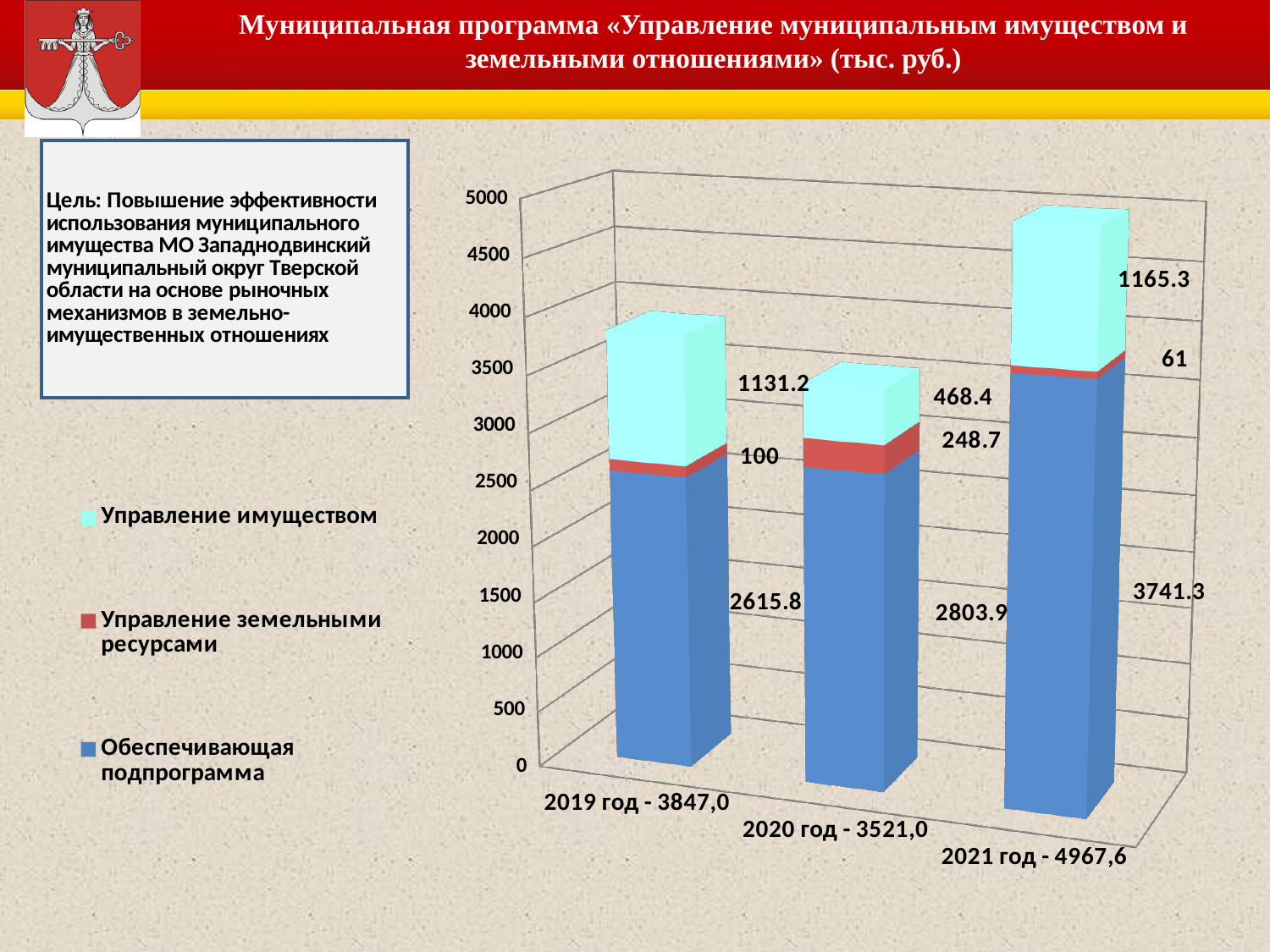
Which series is shown in red in the legend? Управление земельными ресурсами How many series does the legend list? 3 What is the value of Управление земельными ресурсами for 2021? 61 What kind of chart is shown on the slide? Stacked bar chart What is the value of Обеспечивающая подпрограмма for 2019? 2615.8 In which year is the value of Обеспечивающая подпрограмма the highest? 2021 How many years (categories) are plotted on the chart? 3 Which is larger: Управление земельными ресурсами in 2020 or in 2019? 2020 In which year is the value of Управление имуществом the lowest? 2020 What is the difference between the Обеспечивающая подпрограмма values for 2021 and 2020? 937.4 What is the total of the stacked bar for 2021? 4967,6 What is the value of Управление имуществом for 2020? 468.4